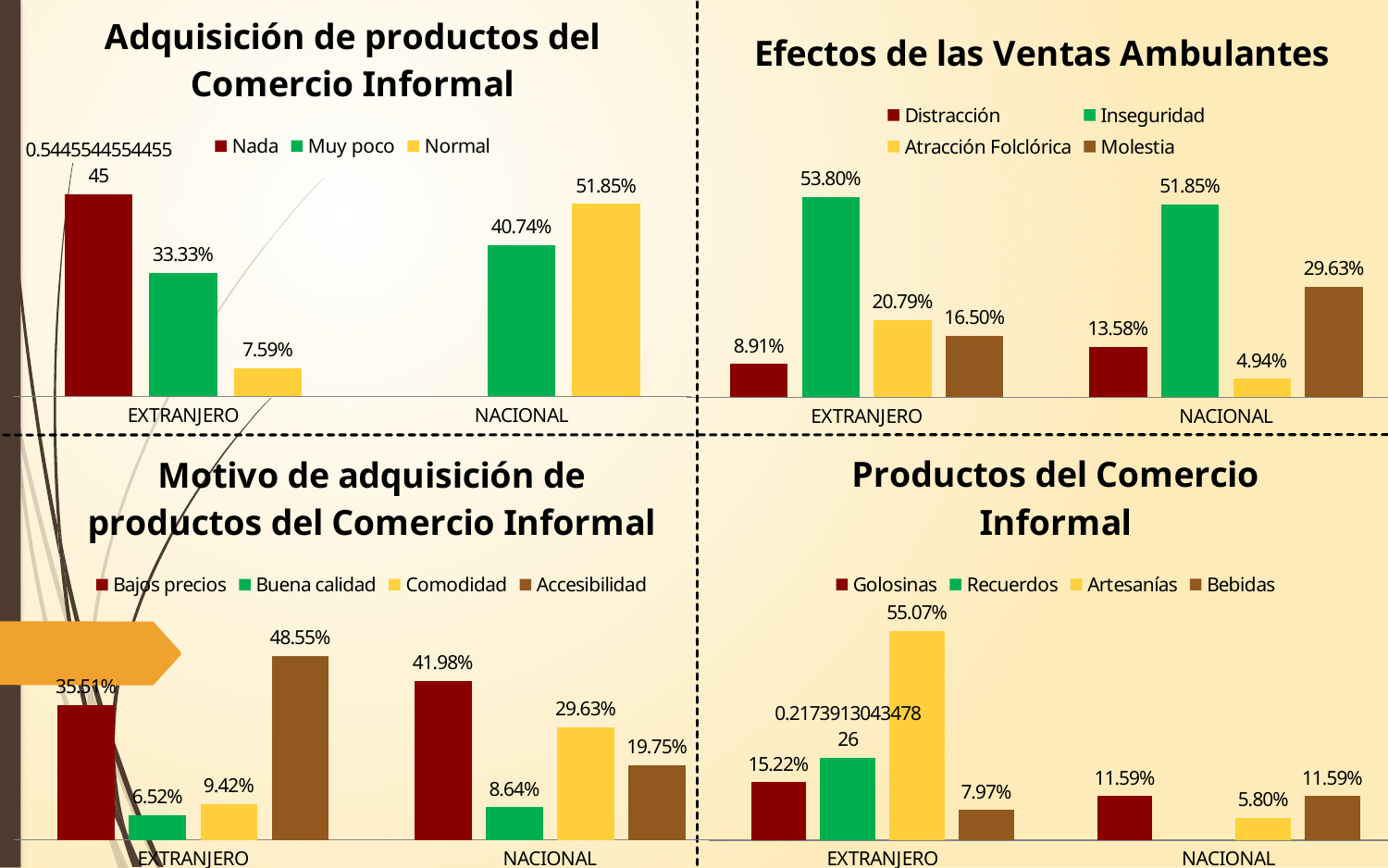
In the 'Adquisición de productos del Comercio Informal' chart, what is the value for Muy poco in the EXTRANJERO group? 33.33% In the 'Motivo de adquisición de productos del Comercio Informal' chart, what is the difference between Bajos precios in NACIONAL (41.98%) and Bajos precios in EXTRANJERO (35.51%)? 6.47% In the 'Productos del Comercio Informal' chart, which is larger: Golosinas in EXTRANJERO or Golosinas in NACIONAL? Golosinas in EXTRANJERO In the 'Motivo de adquisición de productos del Comercio Informal' chart, what is the value for Comodidad in the NACIONAL group? 29.63% In the 'Motivo de adquisición de productos del Comercio Informal' chart, which series has the highest value in the EXTRANJERO group? Accesibilidad In the 'Efectos de las Ventas Ambulantes' chart, which series has the lowest value in the NACIONAL group? Atracción Folclórica In the 'Adquisición de productos del Comercio Informal' chart, how many series does the legend list? 3 In the 'Efectos de las Ventas Ambulantes' chart, what is the value for Inseguridad in the EXTRANJERO group? 53.80% In the 'Productos del Comercio Informal' chart, what is the value for Artesanías in the EXTRANJERO group? 55.07% What kind of chart is the 'Productos del Comercio Informal' chart? Bar chart In the 'Adquisición de productos del Comercio Informal' chart, what is the value for Normal in the NACIONAL group? 51.85% In the 'Efectos de las Ventas Ambulantes' chart, what is the value for Molestia in the NACIONAL group? 29.63%